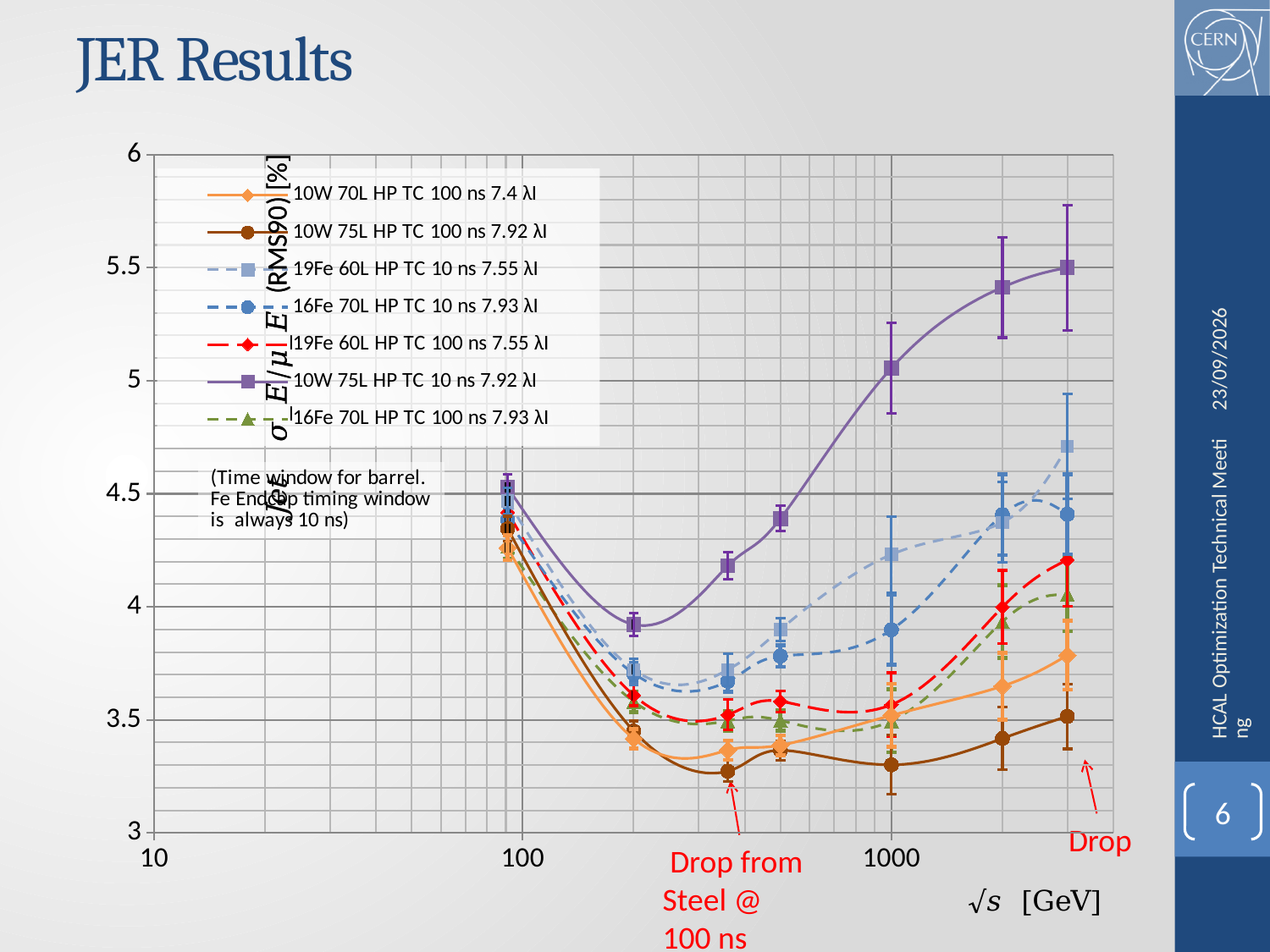
At 1000 GeV, which series has the larger value: 10W 75L HP TC 10 ns 7.92 λI or 10W 75L HP TC 100 ns 7.92 λI? 10W 75L HP TC 10 ns 7.92 λI Which series has the highest value at the rightmost point of the x axis? 10W 75L HP TC 10 ns 7.92 λI How many series does the legend list? 7 Is the value for the 10W 75L HP TC 10 ns 7.92 λI series at its rightmost point greater or less than 5? greater What kind of chart is shown on the slide? line chart What is the label of the x axis? √s [GeV] Is the value for the 19Fe 60L HP TC 10 ns 7.55 λI series at 1000 GeV greater or less than 4? greater Which series has the lowest value at the rightmost point of the x axis? 10W 75L HP TC 100 ns 7.92 λI Does the 10W 75L HP TC 10 ns 7.92 λI series rise or fall between 200 GeV and the rightmost point? rise What is the label of the y axis? Jet σ_E/μ_E (RMS90) [%] Is the value for the 10W 75L HP TC 100 ns 7.92 λI series at 1000 GeV greater or less than 3.5? less